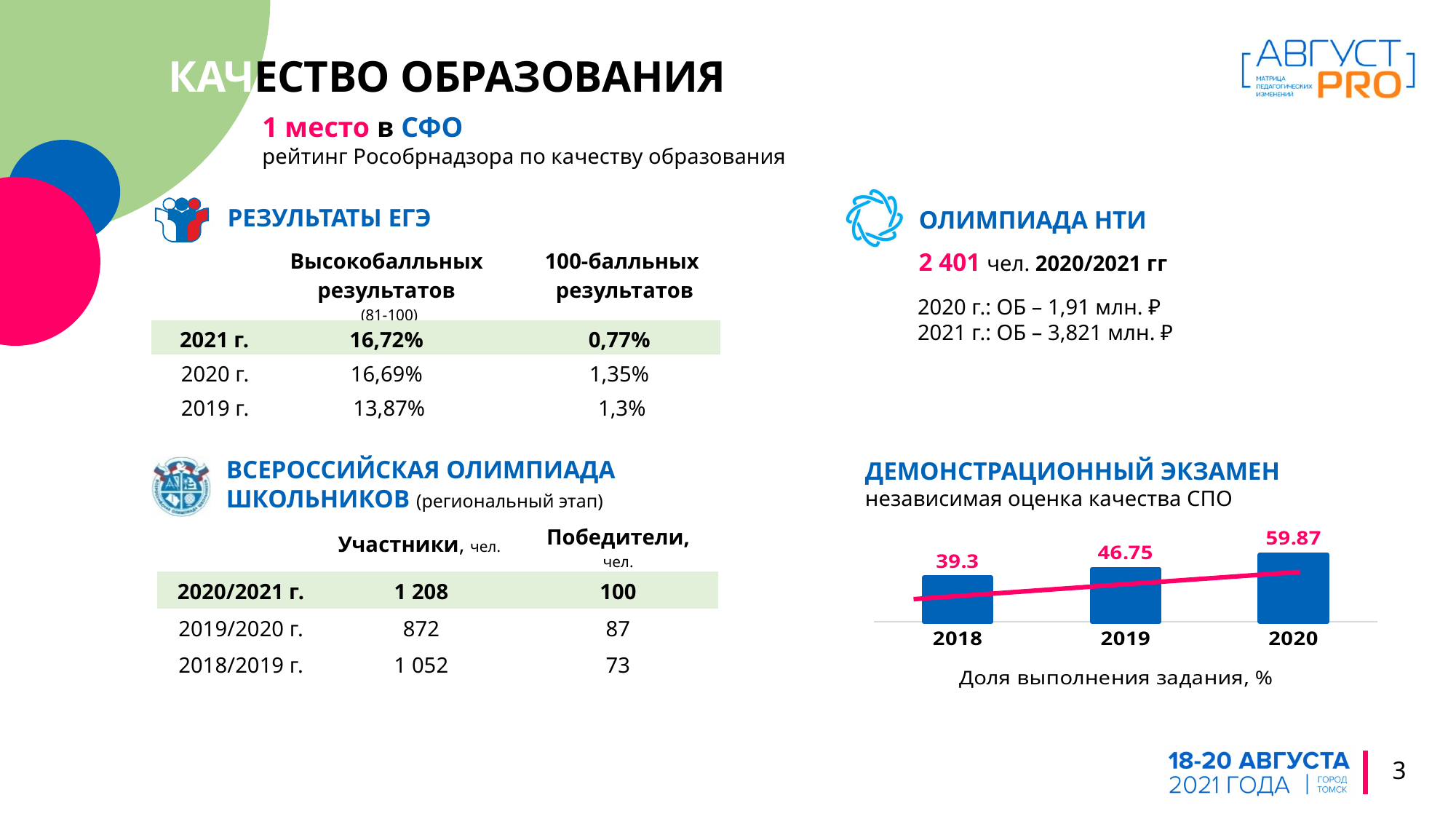
How many years are shown in the Демонстрационный экзамен chart? 3 What is the value for 2020 in the Демонстрационный экзамен chart? 59.87 What kind of chart is the Демонстрационный экзамен chart? bar chart Which year has the lowest value in the Демонстрационный экзамен chart? 2018 Which year has the highest value in the Демонстрационный экзамен chart? 2020 Do the values in the Демонстрационный экзамен chart rise or fall from 2018 to 2020? rise What is the value for 2018 in the Демонстрационный экзамен chart? 39.3 In the Демонстрационный экзамен chart, which is larger: the value for 2019 or the value for 2020? 2020 In the Демонстрационный экзамен chart, what is the difference between the 2020 and 2018 values? 20.57 What does the caption below the Демонстрационный экзамен chart say the values represent? Доля выполнения задания, % In the Демонстрационный экзамен chart, what is the difference between the 2019 and 2018 values? 7.45 What is the value for 2019 in the Демонстрационный экзамен chart? 46.75